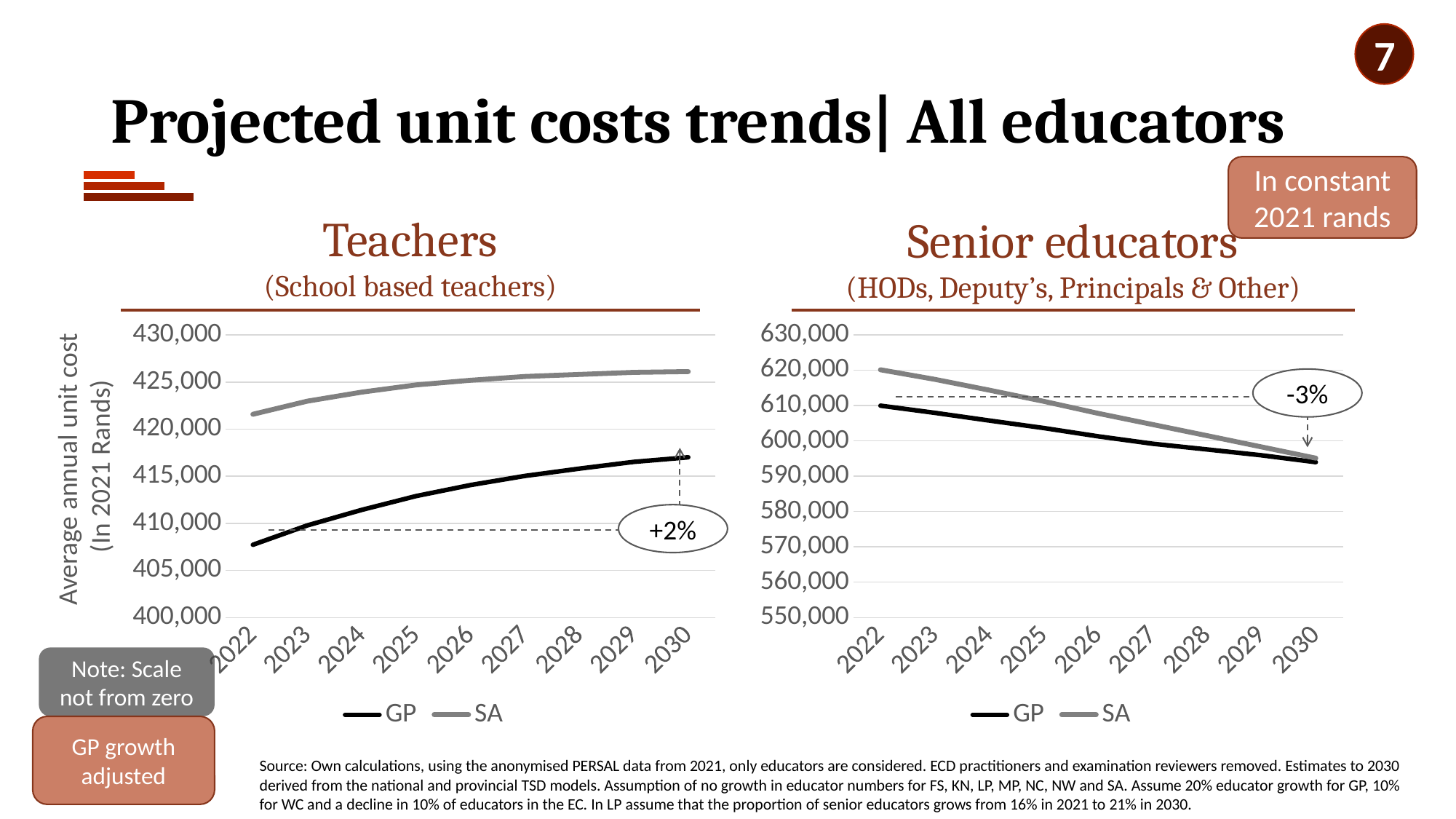
In the Teachers chart, is the SA value for 2022 greater or less than 420,000? greater In the Senior educators chart, which series has the higher value in 2022, GP or SA? SA In the Teachers chart, which series has the higher value in 2022, GP or SA? SA How many series does the legend of the Senior educators chart list? 2 How many years are shown on the x axis of the Teachers chart? 9 In the Teachers chart, is the GP value for 2030 greater or less than 415,000? greater In the Teachers chart, is the GP value for 2022 greater or less than 410,000? less What kind of chart is the Teachers chart? line chart What percentage change is annotated on the Senior educators chart? -3% In the Senior educators chart, does the SA line rise or fall from 2022 to 2030? fall In the Teachers chart, does the GP line rise or fall from 2022 to 2030? rise